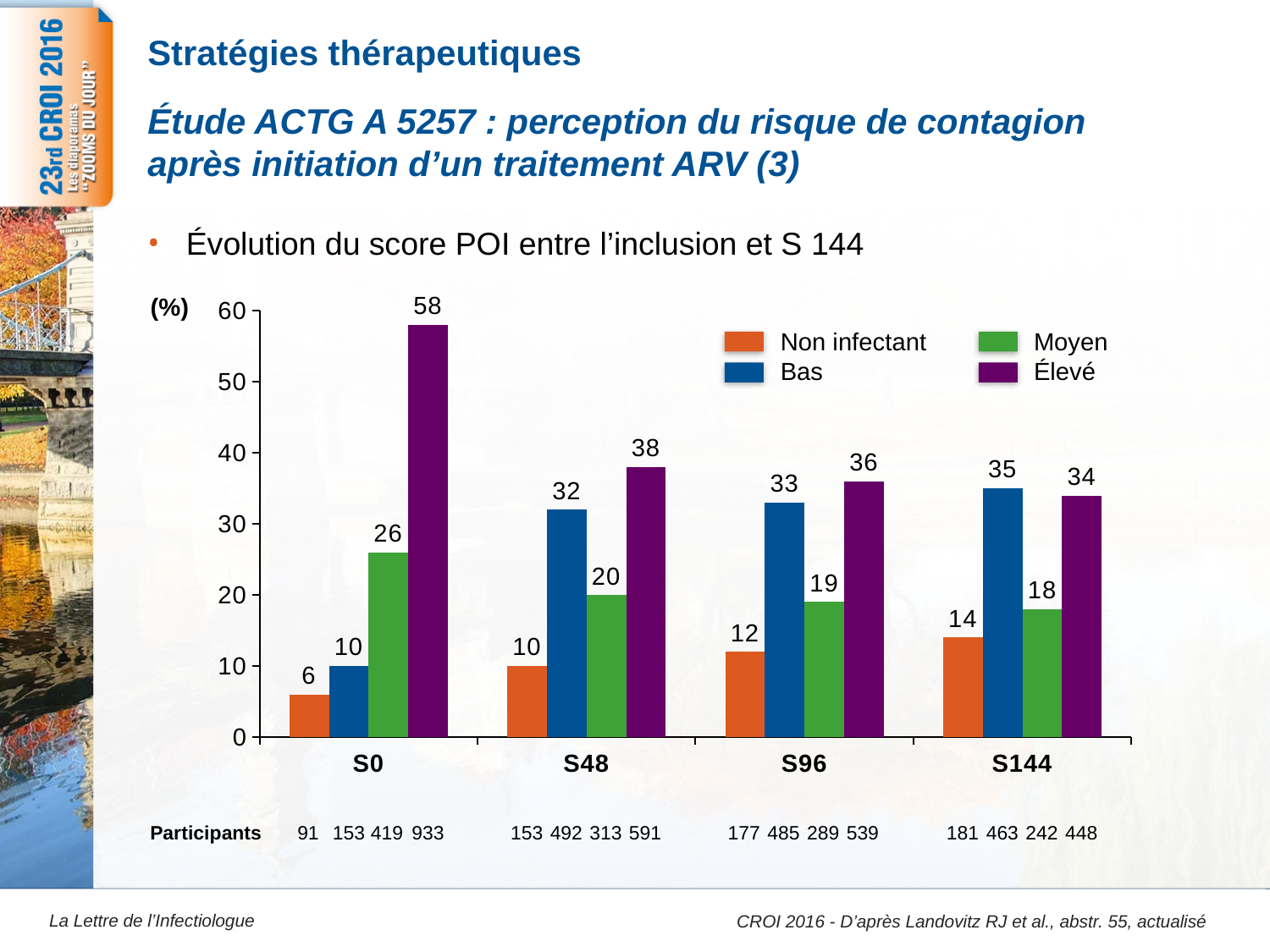
Is the value for Élevé at S0 greater or less than 50? greater Which time point has the lowest value for Non infectant? S0 What is the value for Élevé at S0? 58 Does the value for Bas rise or fall from S0 to S144? rise How many time points are shown on the x axis? 4 How many series does the legend list? 4 Which time point has the highest value for Élevé? S0 What is the value for Bas at S96? 33 What is the difference between the Élevé value at S0 and at S144? 24 What is the value for Non infectant at S144? 14 What kind of chart is shown? bar chart Which is larger at S48: Bas or Moyen? Bas